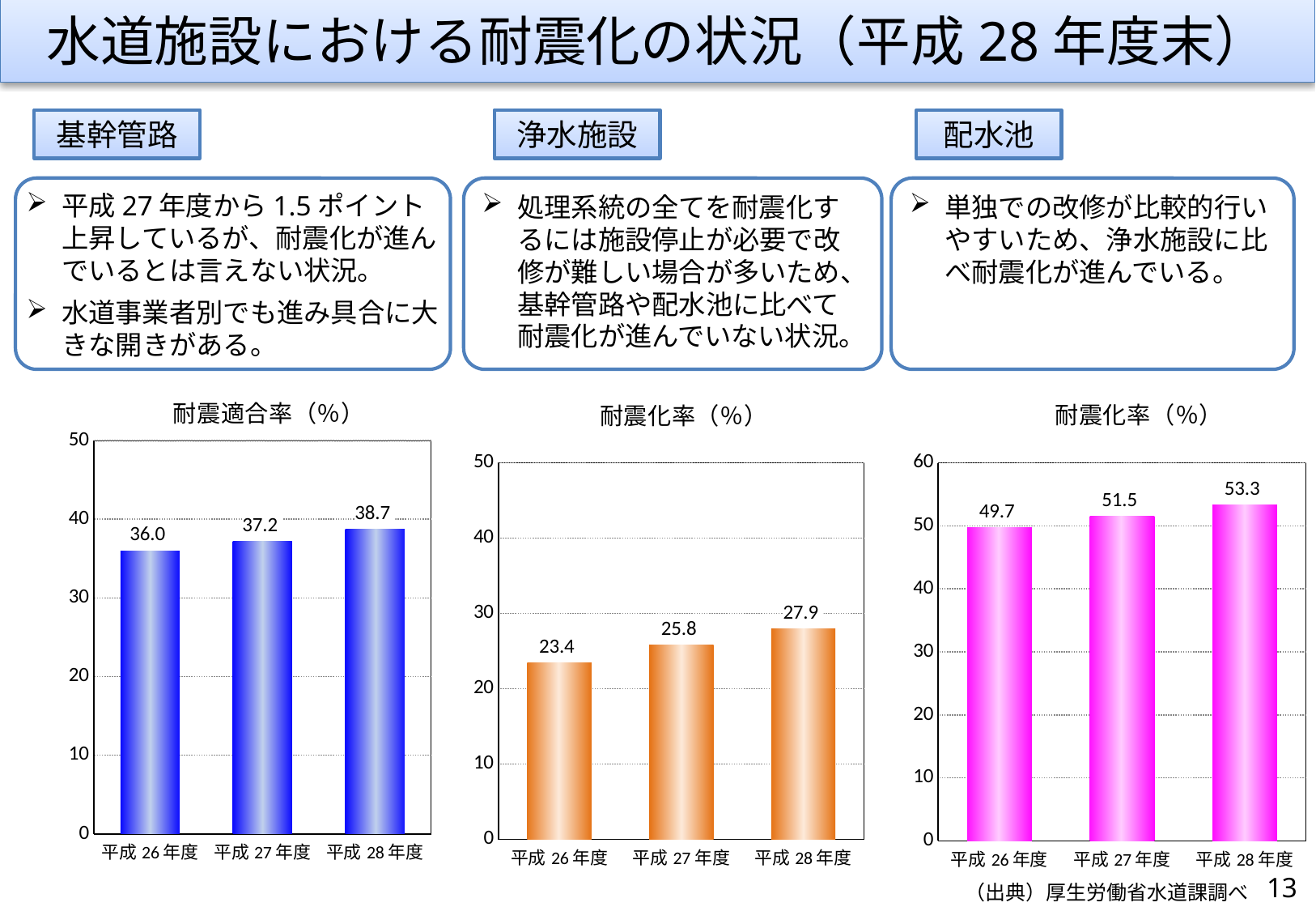
In the middle chart (浄水施設 耐震化率), what is the value for 平成26年度? 23.4 In the left chart (耐震適合率), what is the difference between the values for 平成28年度 and 平成27年度? 1.5 In the middle chart (浄水施設 耐震化率), what is the difference between the values for 平成28年度 and 平成26年度? 4.5 In the right chart (配水池 耐震化率), what is the value for 平成27年度? 51.5 What kind of chart is the right chart (配水池 耐震化率)? Bar chart In the middle chart (浄水施設 耐震化率), which year has the lowest value? 平成26年度 In the left chart (耐震適合率), what is the value for 平成28年度? 38.7 In the right chart (配水池 耐震化率), which year has the highest value? 平成28年度 How many bars does the left chart (耐震適合率) have? 3 In the right chart (配水池 耐震化率), is the value for 平成26年度 greater or less than 40? greater In the middle chart (浄水施設 耐震化率), do the values rise or fall from 平成26年度 to 平成28年度? Rise Which is larger: the 平成28年度 value in the left chart (耐震適合率) or the 平成28年度 value in the middle chart (浄水施設 耐震化率)? The left chart (38.7)